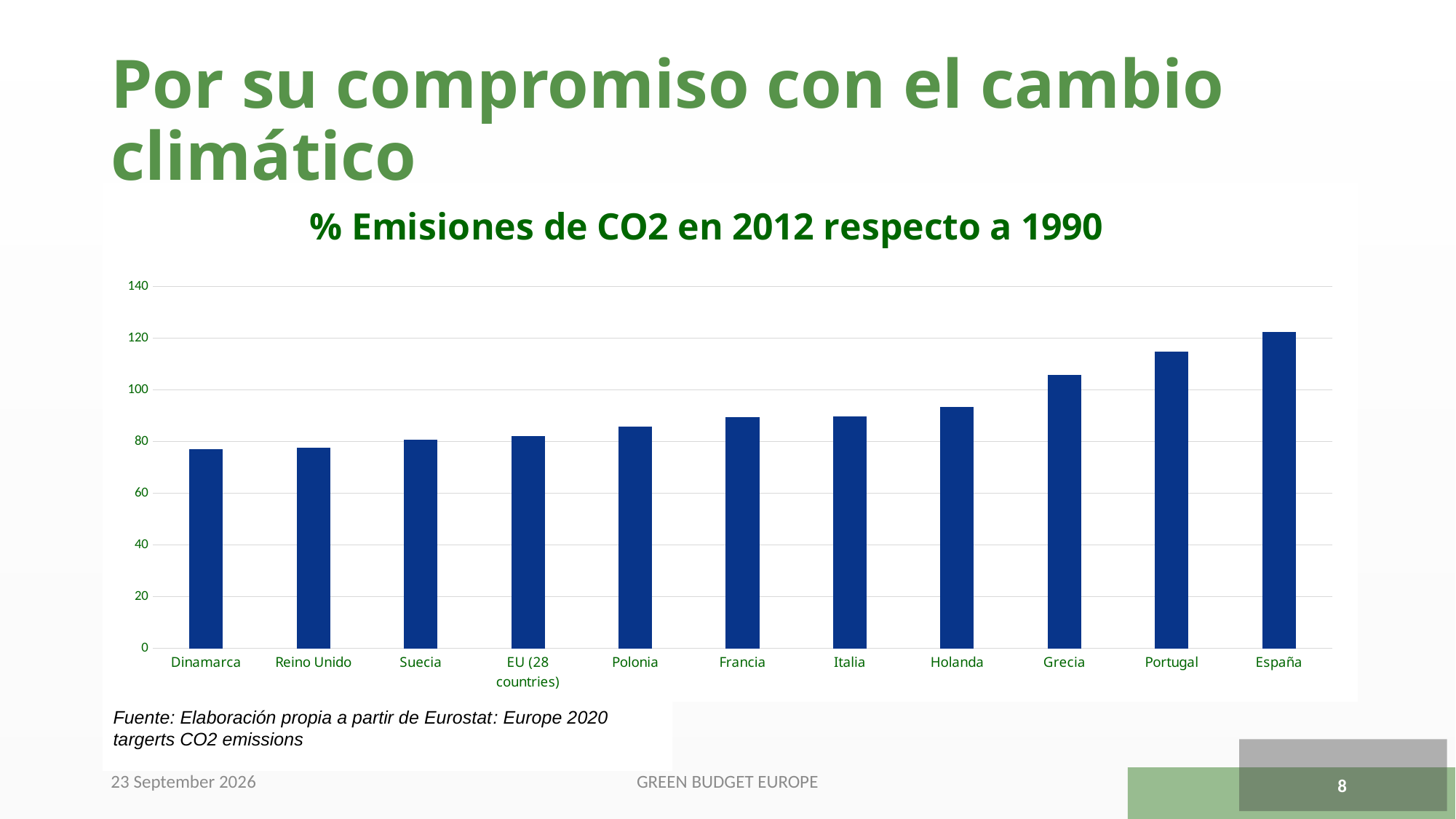
What is the title of the chart? % Emisiones de CO2 en 2012 respecto a 1990 Is the value for Dinamarca greater or less than 80? less Is the value for Holanda greater or less than 100? less Which category has the highest value in the chart? España Which has a larger value, España or Dinamarca? España Is the value for Grecia greater or less than 100? greater Which has a larger value, Polonia or Grecia? Grecia What colour are the bars in the chart? dark blue What kind of chart is shown on the slide? bar chart How many countries or regions are shown on the x axis of the chart? 11 Do the values rise or fall from left to right along the x axis? rise